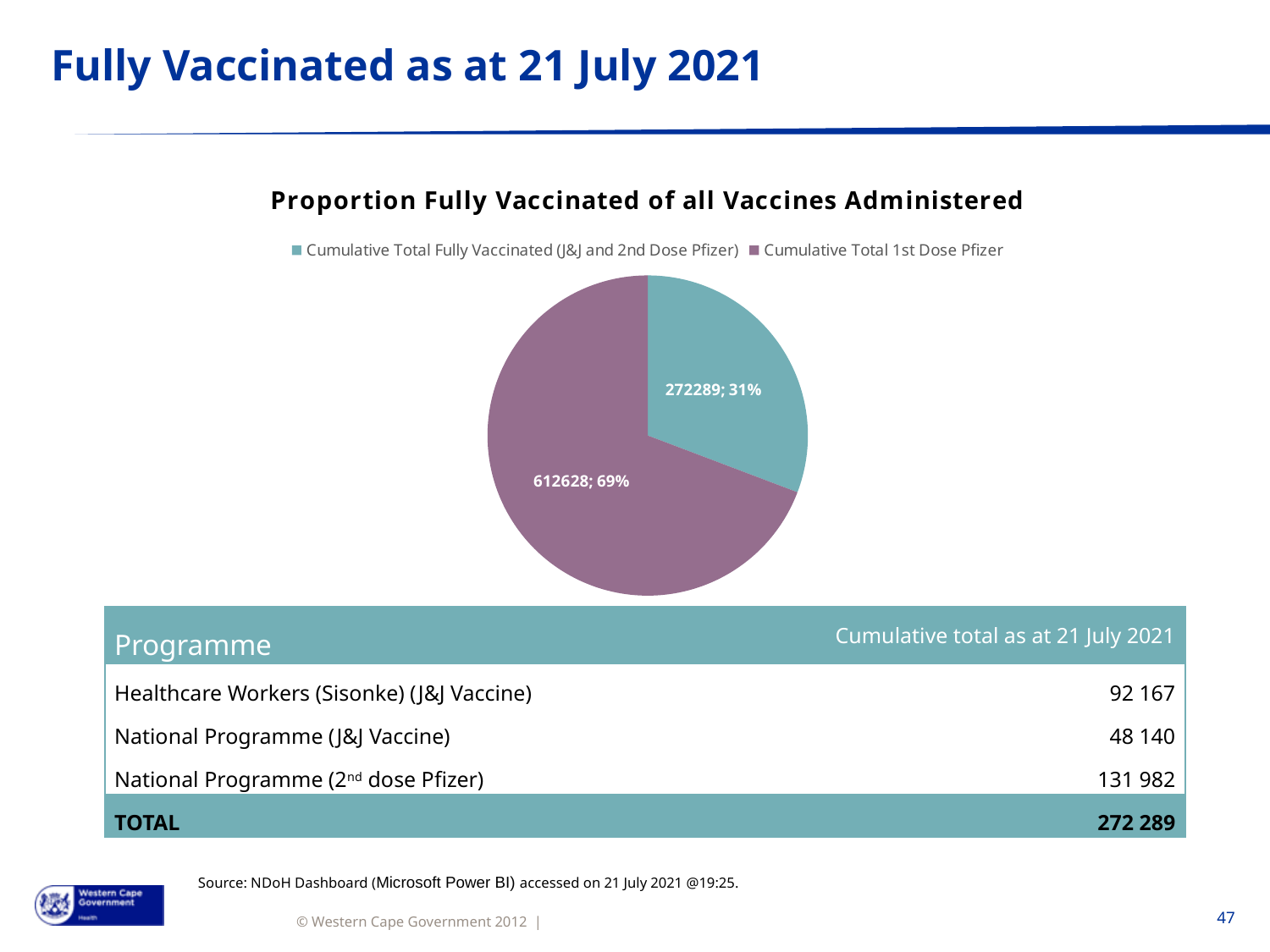
How many series does the chart's legend list? 2 Which slice of the pie is the largest? Cumulative Total 1st Dose Pfizer What is the difference between the Cumulative Total 1st Dose Pfizer value and the Cumulative Total Fully Vaccinated (J&J and 2nd Dose Pfizer) value? 340339 What kind of chart is shown on the slide? pie chart What share of the pie is Cumulative Total 1st Dose Pfizer? 69% How many slices does the pie chart have? 2 What is the value for Cumulative Total 1st Dose Pfizer? 612628 What share of the pie is Cumulative Total Fully Vaccinated (J&J and 2nd Dose Pfizer)? 31% Which colour represents Cumulative Total 1st Dose Pfizer in the pie chart? purple Which slice of the pie is the smallest? Cumulative Total Fully Vaccinated (J&J and 2nd Dose Pfizer) What is the value for Cumulative Total Fully Vaccinated (J&J and 2nd Dose Pfizer)? 272289 What is the title of the chart? Proportion Fully Vaccinated of all Vaccines Administered